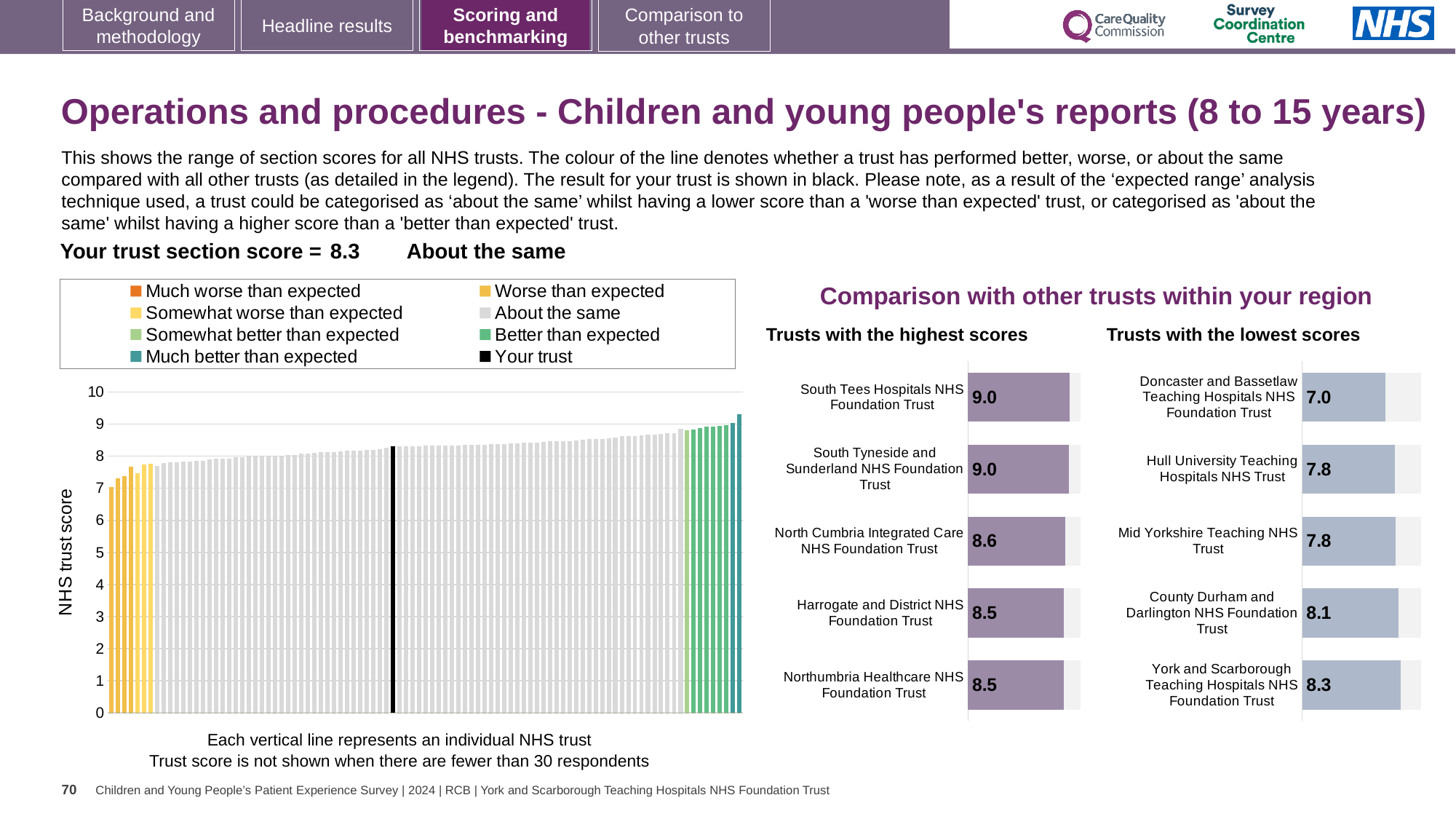
In the 'Trusts with the lowest scores' chart, which trust has the highest score? York and Scarborough Teaching Hospitals NHS Foundation Trust In the 'Trusts with the lowest scores' chart, which trust has the lowest score? Doncaster and Bassetlaw Teaching Hospitals NHS Foundation Trust In the large chart on the left, do the trust scores rise or fall from left to right along the x axis? Rise In the 'Trusts with the highest scores' chart, what is the score for North Cumbria Integrated Care NHS Foundation Trust? 8.6 In the 'Trusts with the highest scores' chart, what is the difference between the scores of South Tees Hospitals NHS Foundation Trust and North Cumbria Integrated Care NHS Foundation Trust? 0.4 What kind of chart is the large chart on the left showing NHS trust scores? Bar chart In the 'Trusts with the lowest scores' chart, what is the score for Hull University Teaching Hospitals NHS Trust? 7.8 In the 'Trusts with the lowest scores' chart, what is the difference between the scores of York and Scarborough Teaching Hospitals NHS Foundation Trust and Doncaster and Bassetlaw Teaching Hospitals NHS Foundation Trust? 1.3 In the 'Trusts with the highest scores' chart, which has the larger score: South Tees Hospitals NHS Foundation Trust or Harrogate and District NHS Foundation Trust? South Tees Hospitals NHS Foundation Trust How many entries does the legend of the large chart on the left list? 8 How many trusts are shown in the 'Trusts with the lowest scores' chart? 5 In the 'Trusts with the highest scores' chart, what is the score for Harrogate and District NHS Foundation Trust? 8.5